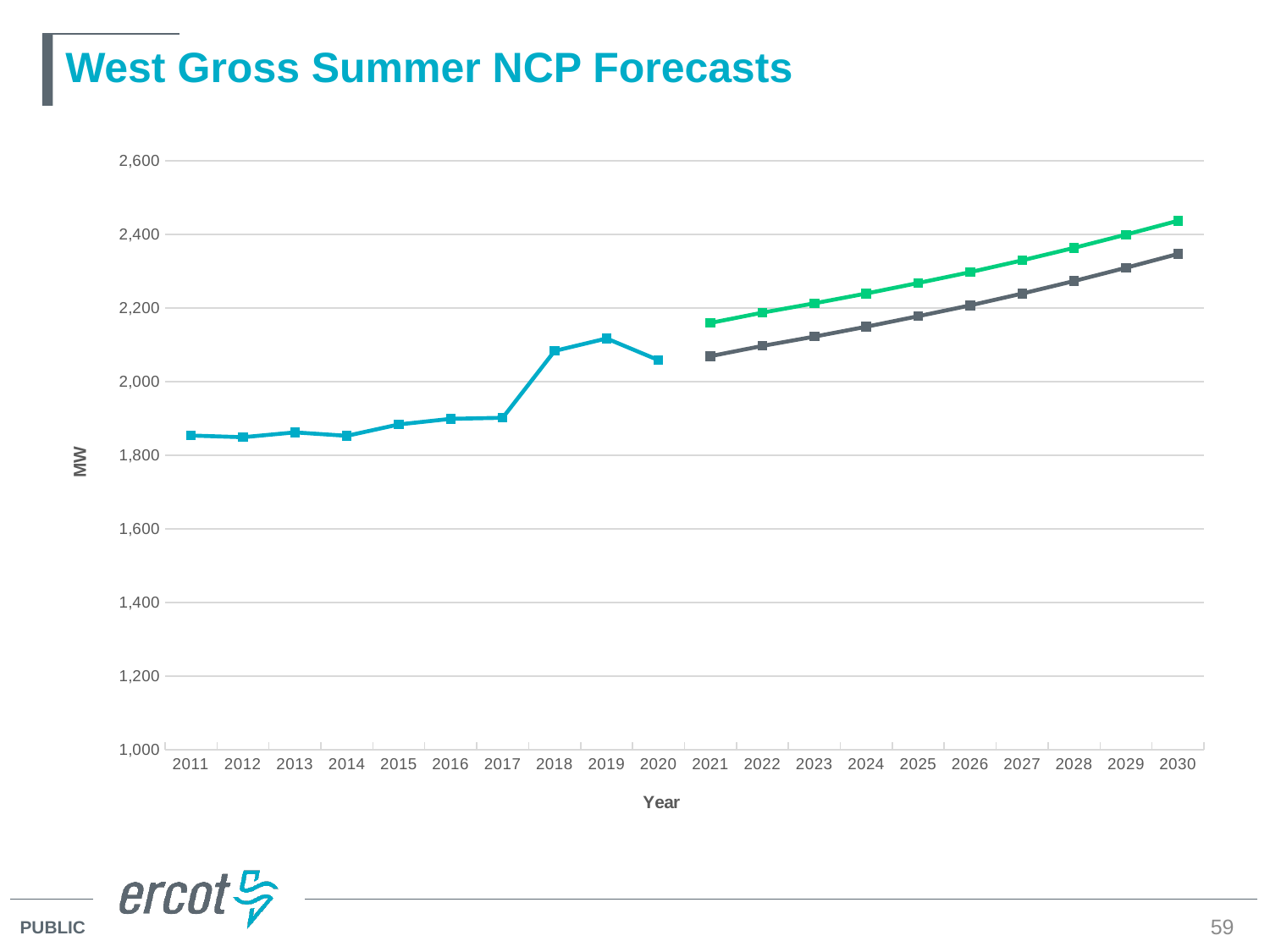
Is the value of the blue line for 2018 greater or less than 2,000? greater How many years are shown on the x axis of the chart? 20 What kind of chart is shown on the slide? line chart What is the label on the vertical axis of the chart? MW In 2025, which line has the higher value, the green line or the dark gray line? the green line Is the value of the dark gray line for 2030 greater or less than 2,400? less In which year does the blue line reach its highest value? 2019 Is the value of the green line for 2030 greater or less than 2,400? greater Do the green and dark gray lines rise or fall from 2021 to 2030? rise What is the title of the chart? West Gross Summer NCP Forecasts